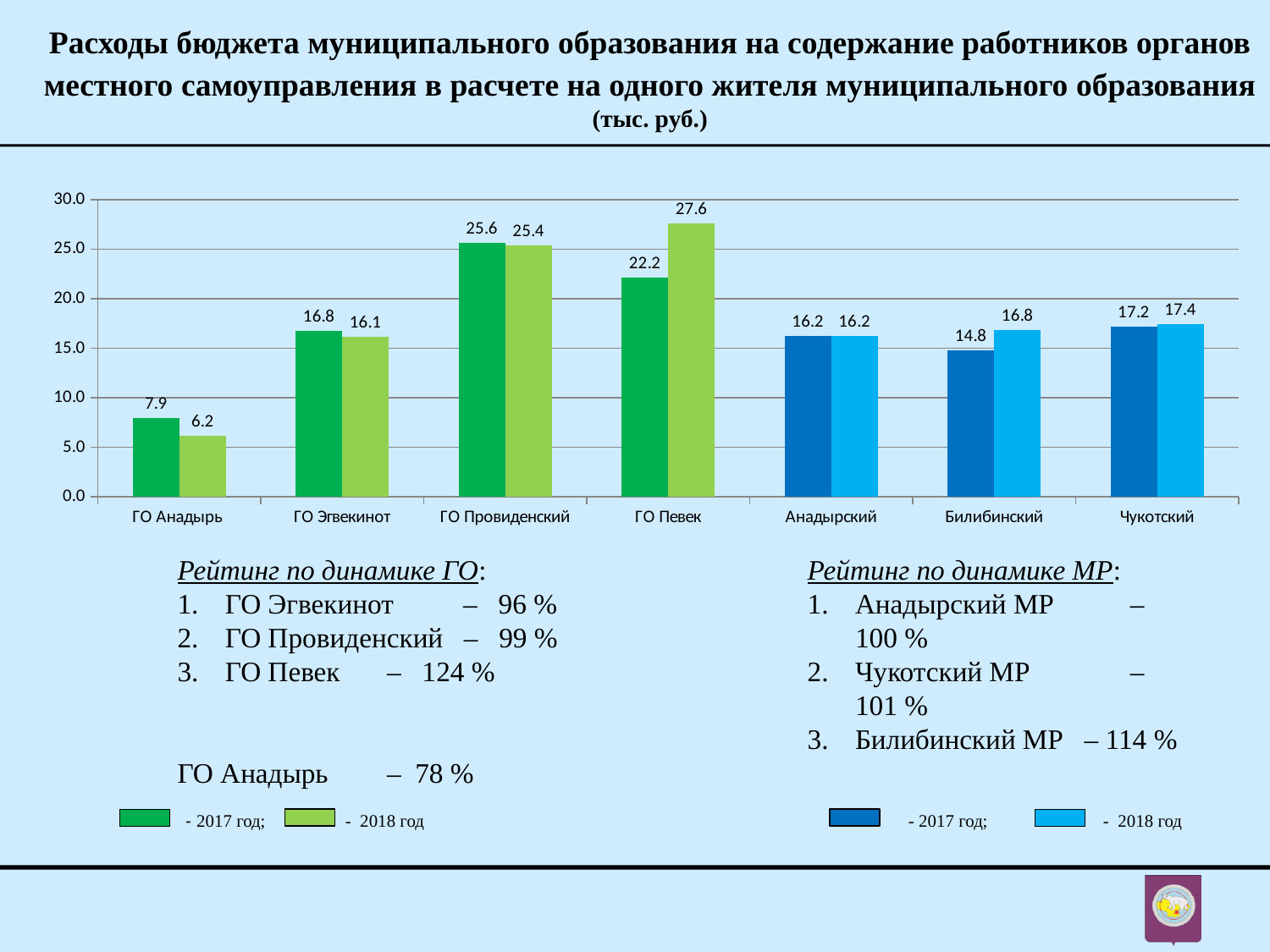
Which category has the lowest 2017 value? ГО Анадырь What is the 2017 value for ГО Певек? 22.2 Which is larger: the 2018 value for ГО Певек or the 2018 value for ГО Провиденский? ГО Певек Which category has the highest 2018 value? ГО Певек What is the 2018 value for ГО Анадырь? 6.2 What is the difference between the 2018 and 2017 values for Билибинский? 2.0 Which category has the highest 2017 value? ГО Провиденский What is the difference between the 2018 and 2017 values for ГО Певек? 5.4 What kind of chart is shown on the slide? bar chart Is the 2018 value for ГО Анадырь greater or less than 10.0? less How many categories are shown on the x axis of the chart? 7 What is the 2018 value for Билибинский? 16.8